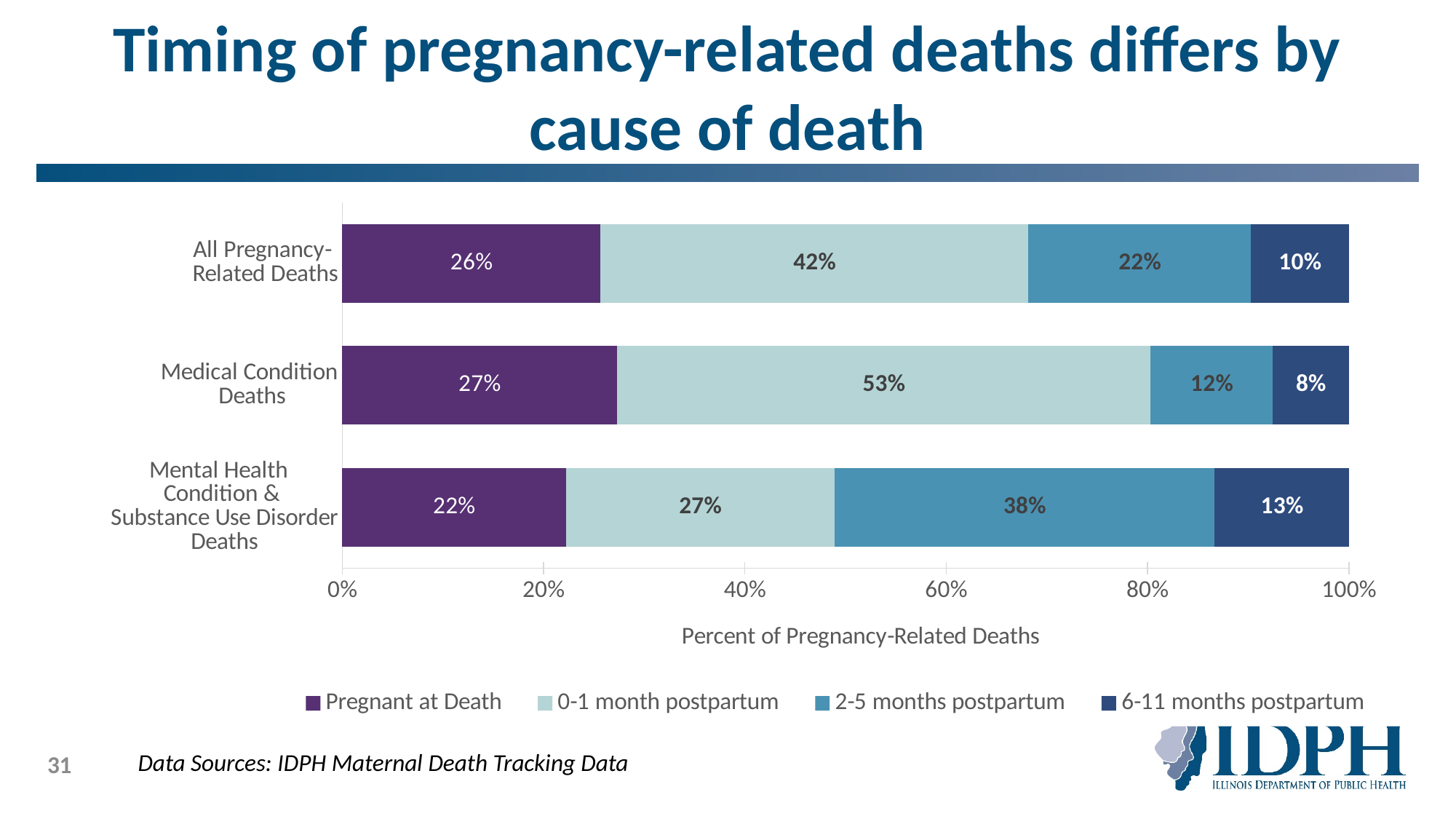
What percentage of Medical Condition Deaths occurred 0-1 month postpartum? 53% What percentage of Mental Health Condition & Substance Use Disorder Deaths occurred 6-11 months postpartum? 13% What percentage of All Pregnancy-Related Deaths occurred while Pregnant at Death? 26% Which category has the lowest value for 2-5 months postpartum? Medical Condition Deaths Which is larger: the 0-1 month postpartum share for All Pregnancy-Related Deaths or for Mental Health Condition & Substance Use Disorder Deaths? All Pregnancy-Related Deaths How many series does the legend list? 4 What is the difference between the 2-5 months postpartum values for Mental Health Condition & Substance Use Disorder Deaths and Medical Condition Deaths? 26 percentage points What percentage of Mental Health Condition & Substance Use Disorder Deaths occurred 2-5 months postpartum? 38% What is the label of the x axis? Percent of Pregnancy-Related Deaths What kind of chart is shown on the slide? Stacked bar chart How many categories (bars) are shown on the chart? 3 Which category has the highest value for 0-1 month postpartum? Medical Condition Deaths